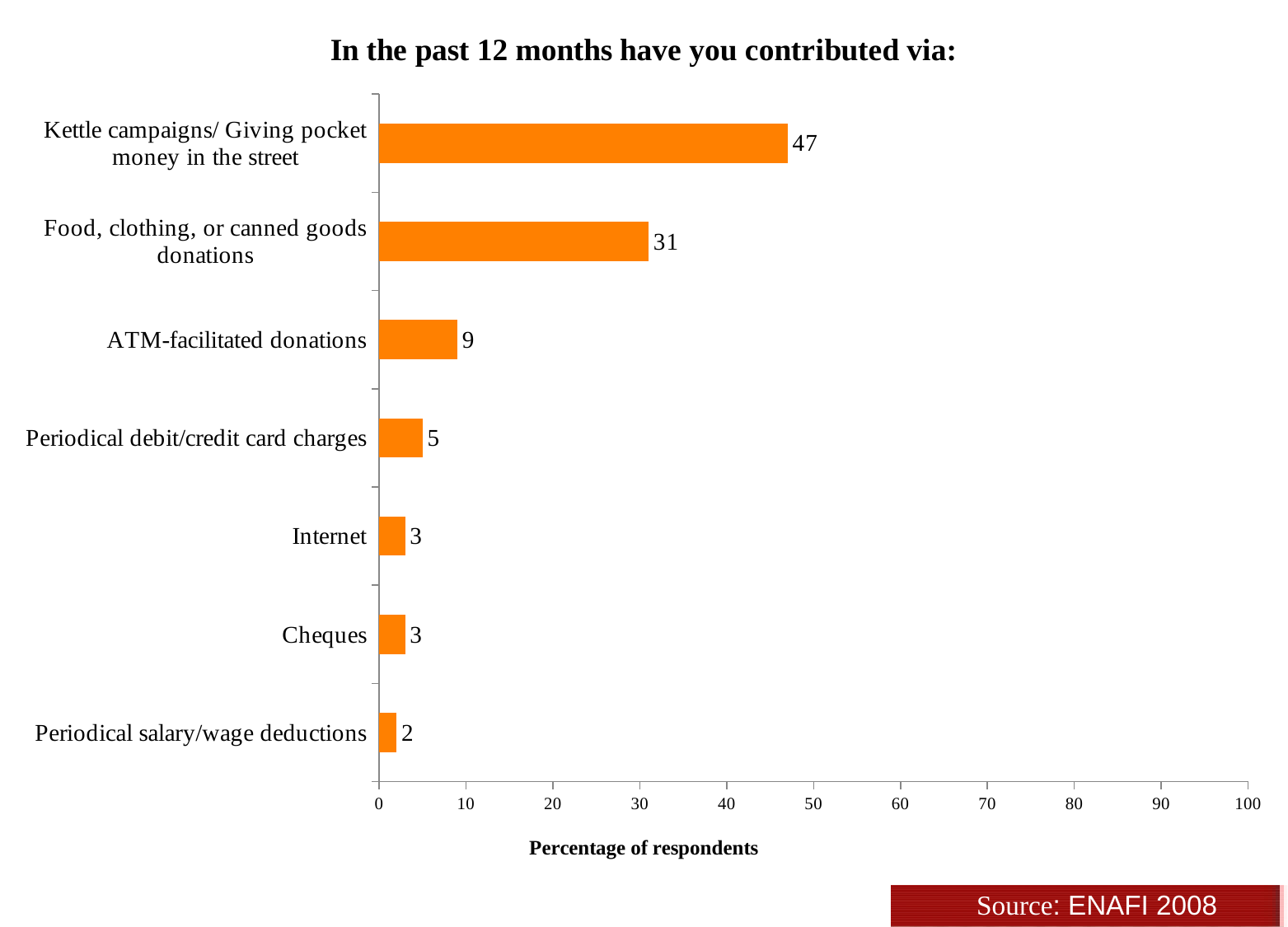
How many contribution methods are shown in the chart? 7 What percentage of respondents contributed via kettle campaigns/giving pocket money in the street? 47 What is the label of the horizontal axis? Percentage of respondents Which contribution method has the lowest percentage of respondents? Periodical salary/wage deductions Is the value for food, clothing, or canned goods donations greater or less than 40? less What is the difference between the values for kettle campaigns and food, clothing, or canned goods donations? 16 Which contribution method has the highest percentage of respondents? Kettle campaigns/ Giving pocket money in the street What kind of chart is shown on the slide? Bar chart What percentage of respondents contributed via ATM-facilitated donations? 9 What is the value for food, clothing, or canned goods donations? 31 Which is larger: the value for ATM-facilitated donations or for periodical debit/credit card charges? ATM-facilitated donations What is the value for periodical salary/wage deductions? 2